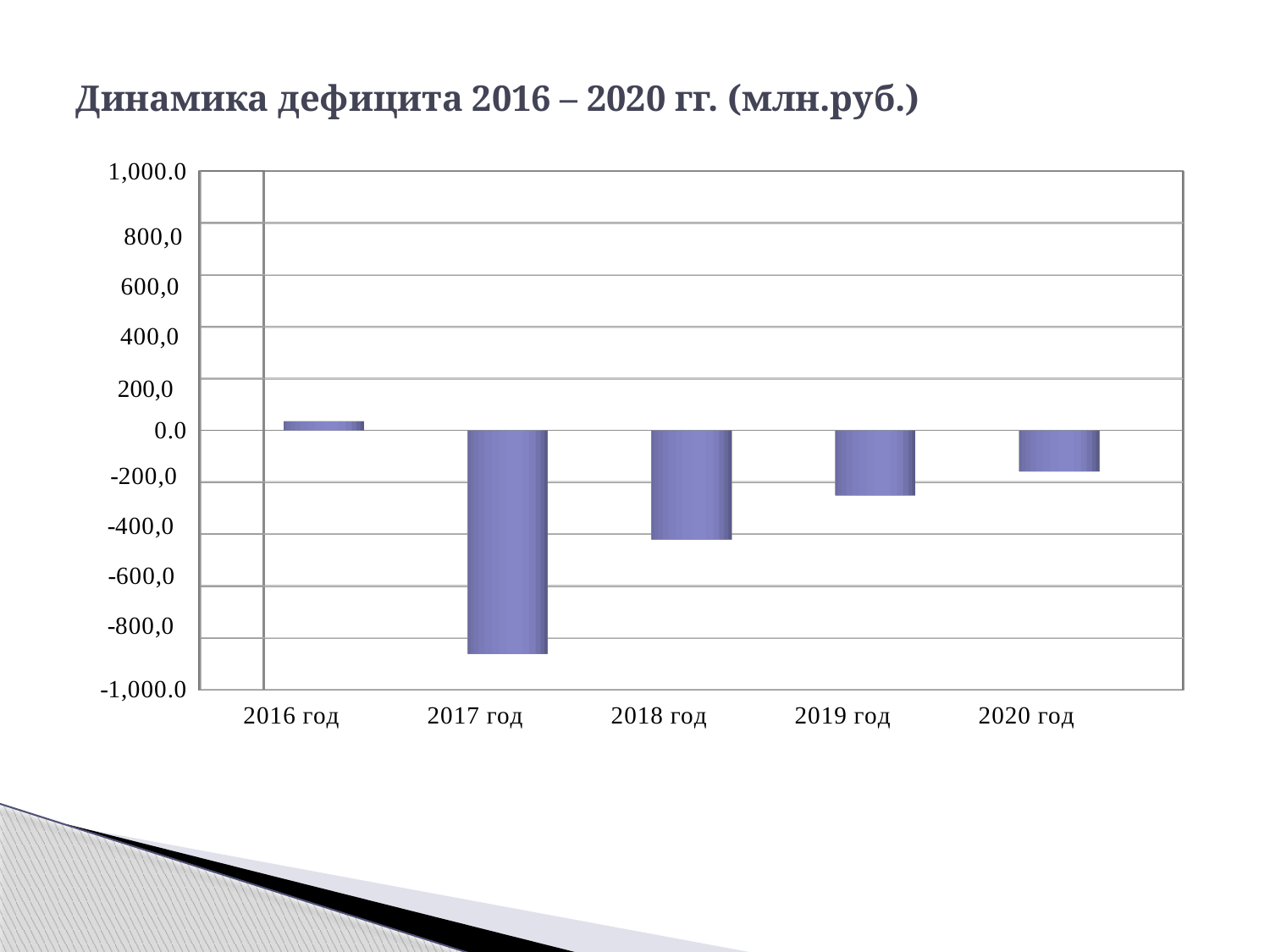
How many years (categories) are plotted on the chart? 5 Is the value for 2016 год greater or less than 0,0? greater Is the value for 2017 год greater or less than -800,0? less Is the value for 2020 год greater or less than -200,0? greater What is the title of the chart? Динамика дефицита 2016 – 2020 гг. (млн.руб.) What is the lowest value shown on the vertical axis? -1,000.0 Which year has the highest value on the chart? 2016 год Which year has the lowest value on the chart? 2017 год Which is larger, the value for 2018 год or the value for 2019 год? 2019 год Do the values rise or fall from 2017 год to 2020 год? rise What kind of chart is shown on the slide? bar chart